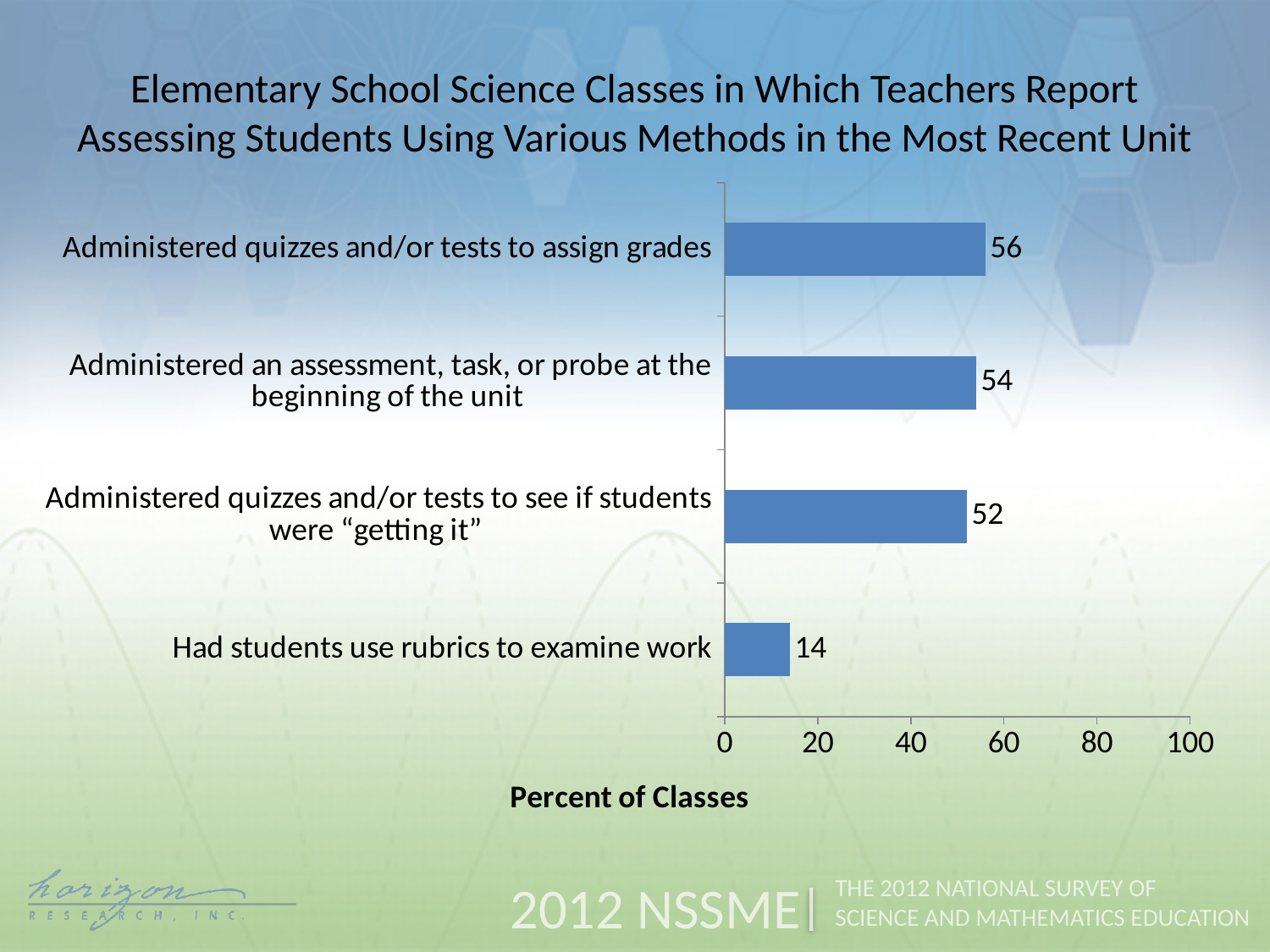
What percent of classes administered an assessment, task, or probe at the beginning of the unit? 54 What is the difference in percent of classes between administering quizzes and/or tests to assign grades and having students use rubrics to examine work? 42 What is the label of the horizontal axis? Percent of Classes Which is larger: the percent of classes that administered an assessment at the beginning of the unit, or the percent that had students use rubrics to examine work? Administered an assessment, task, or probe at the beginning of the unit Which assessment method has the lowest percent of classes? Had students use rubrics to examine work What percent of classes had students use rubrics to examine work? 14 Which assessment method has the highest percent of classes? Administered quizzes and/or tests to assign grades What percent of classes administered quizzes and/or tests to assign grades? 56 What percent of classes administered quizzes and/or tests to see if students were "getting it"? 52 Is the value for 'Had students use rubrics to examine work' greater or less than 20? less How many assessment methods are shown in the chart? 4 What kind of chart is shown on the slide? Bar chart